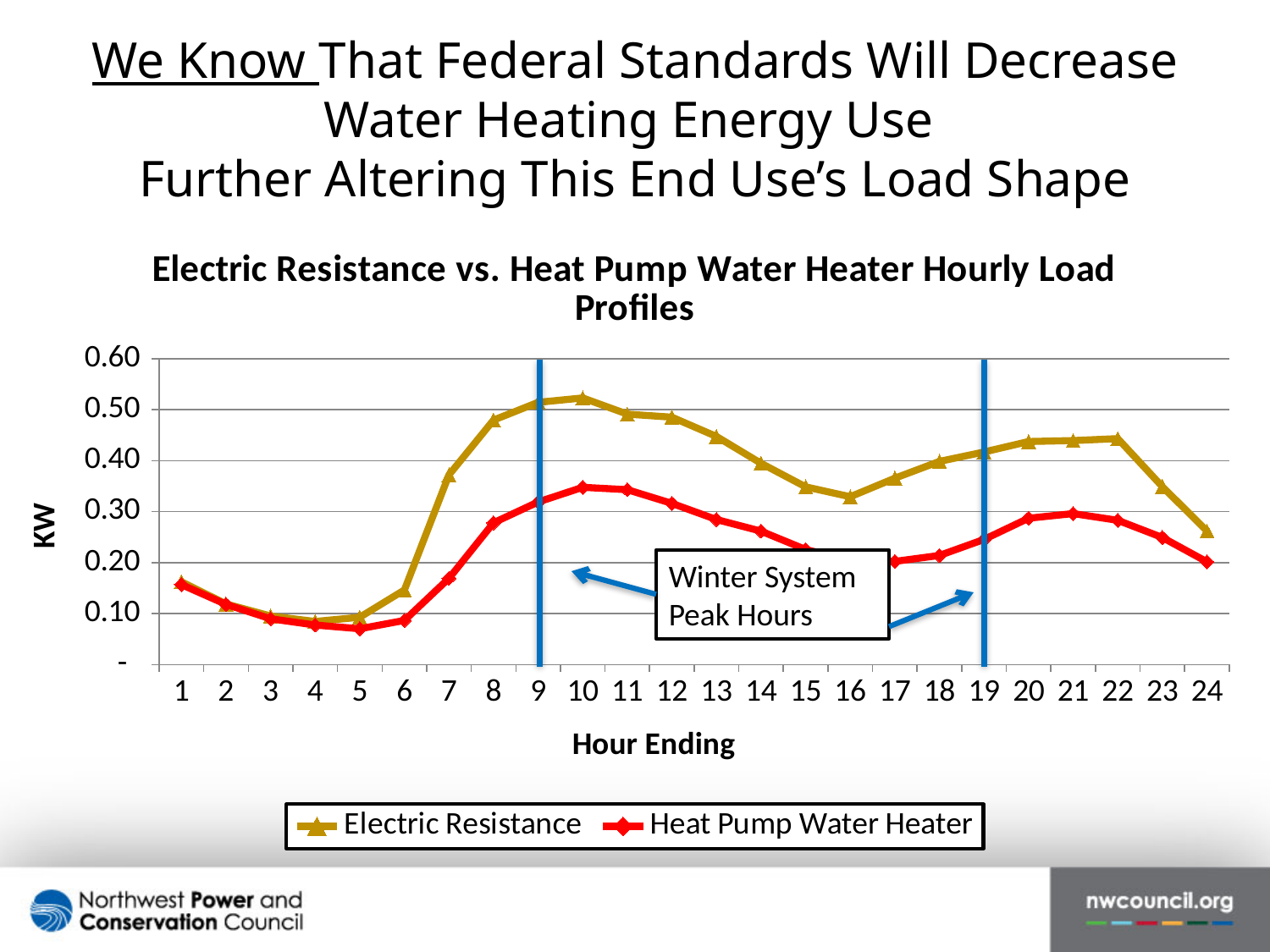
Is the Electric Resistance value at hour ending 7 greater or less than 0.30? greater What do the two vertical blue lines on the chart mark, according to the annotation? Winter System Peak Hours Is the Heat Pump Water Heater value at hour ending 10 greater or less than 0.30? greater What kind of chart is shown on the slide? Line chart What is the title of the chart? Electric Resistance vs. Heat Pump Water Heater Hourly Load Profiles Is the Electric Resistance value at hour ending 16 greater or less than 0.40? less How many hours are plotted along the x axis? 24 Does the Heat Pump Water Heater line rise or fall from hour ending 10 to hour ending 15? fall At hour ending 10, which series has the higher value, Electric Resistance or Heat Pump Water Heater? Electric Resistance Does the Electric Resistance line rise or fall from hour ending 5 to hour ending 9? rise How many series does the legend list? 2